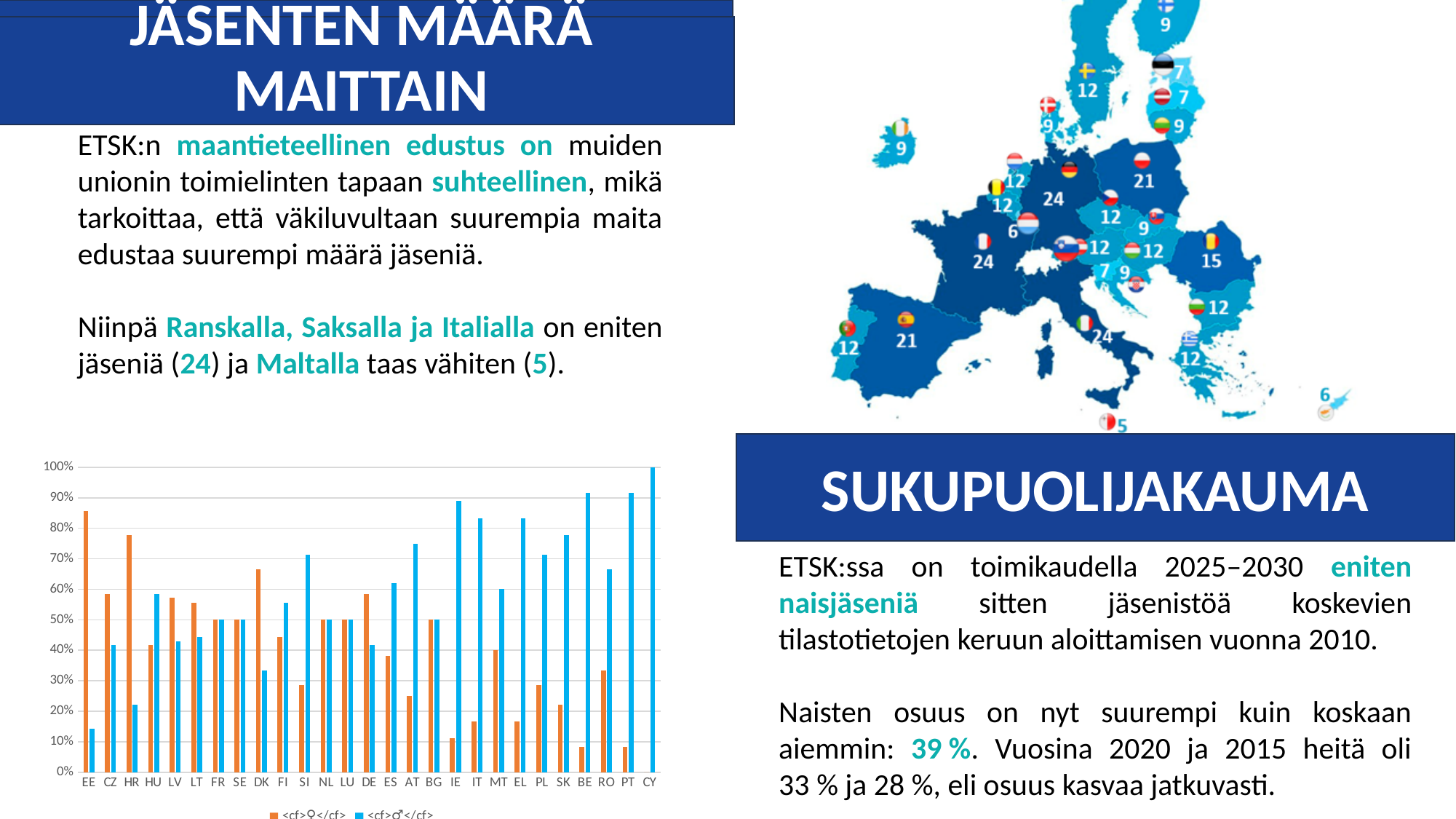
What kind of chart is shown at the bottom left of the slide? bar chart In the bar chart, is the orange bar for EE greater or less than 80%? greater In the bar chart, which country has the highest blue bar? CY In the bar chart, what is the value of the blue bar for CY? 100% In the bar chart, is the blue bar for IE greater or less than 80%? greater In the bar chart, which country has the highest orange bar? EE In the bar chart, is the orange bar for BE greater or less than 10%? less In the bar chart, what is the value of the orange bar for FR? 50% In the bar chart, what is the value of the blue bar for NL? 50% In the bar chart, for IT, which bar is larger, the orange one or the blue one? the blue one How many series does the legend of the bar chart list? 2 How many countries (categories) are shown on the x axis of the bar chart? 27